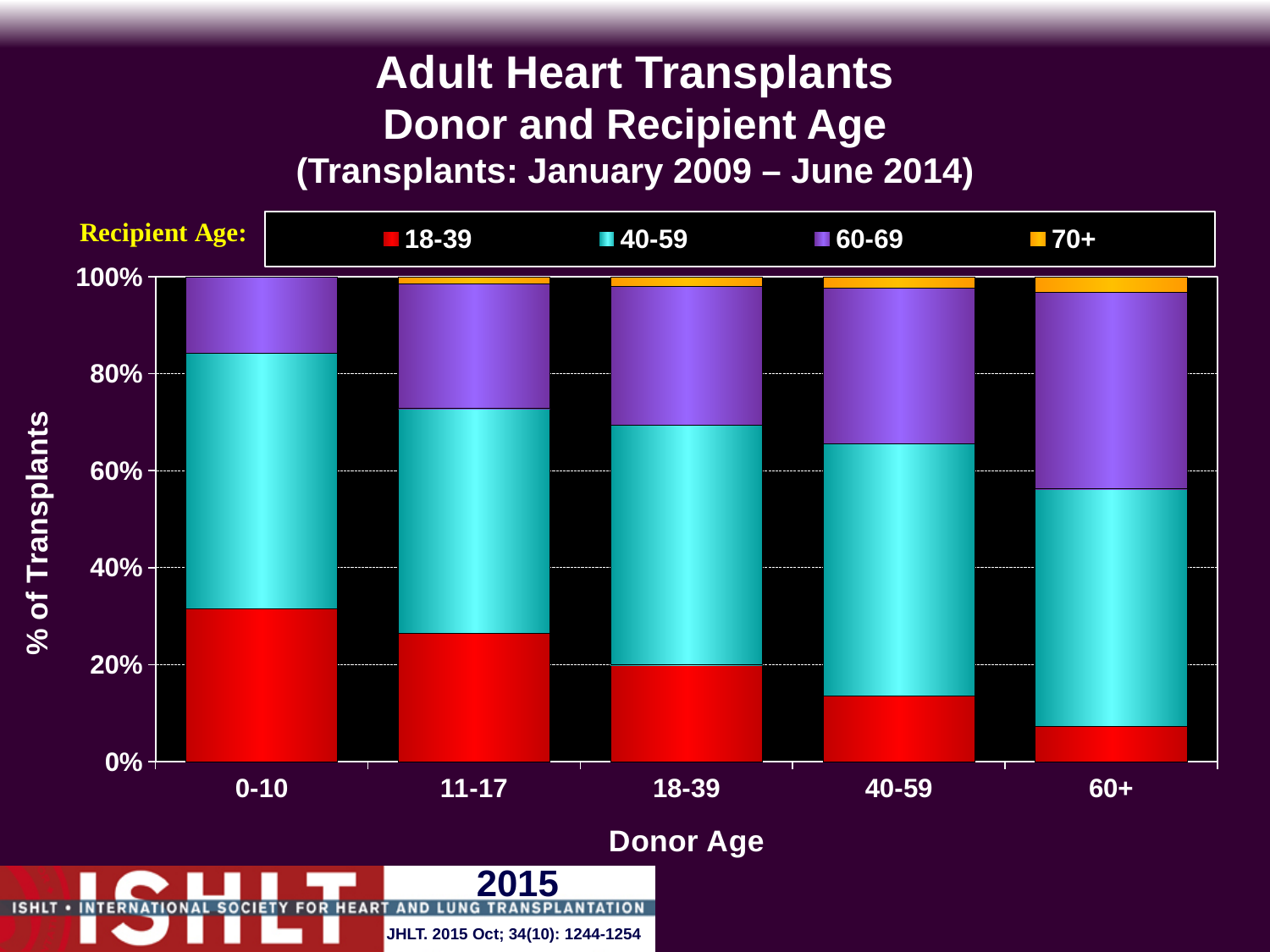
How many donor age categories are shown on the x axis? 5 Which donor age group has the largest share of recipients aged 60-69? 60+ Which donor age group has the largest share of recipients aged 18-39? 0-10 Which donor age group has the smallest share of recipients aged 18-39? 60+ Is the share of recipients aged 18-39 for donor age 0-10 greater or less than 20%? greater What kind of chart is shown on the slide? Stacked bar chart Which is larger: the share of recipients aged 18-39 for donor age 0-10 or for donor age 40-59? 0-10 Is the share of recipients aged 18-39 for donor age 60+ greater or less than 20%? less Which donor age group has the smallest share of recipients aged 60-69? 0-10 How many recipient age series does the legend list? 4 Does the share of recipients aged 18-39 rise or fall as donor age increases along the x axis? Fall What is the title of the y axis? % of Transplants